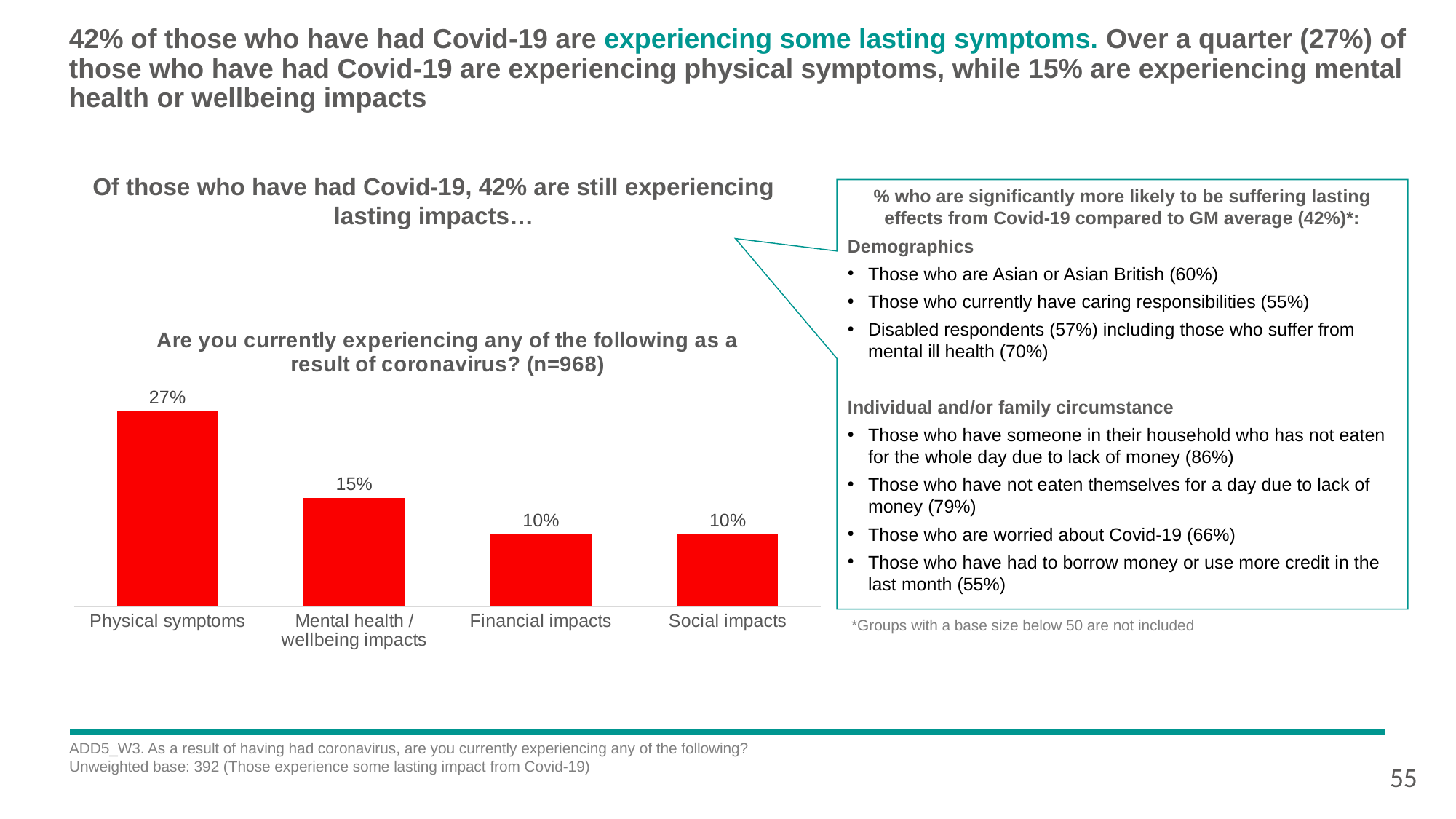
What is the value shown for mental health / wellbeing impacts? 15% Which category has the highest value in the chart? Physical symptoms How many categories are shown in the bar chart? 4 What type of chart is used to show the lasting impacts of coronavirus? Bar chart What is the difference between the values for mental health / wellbeing impacts and financial impacts? 5 percentage points Which is larger, the value for physical symptoms or the value for social impacts? Physical symptoms What percentage are experiencing financial impacts? 10% What percentage of respondents are experiencing physical symptoms as a result of coronavirus? 27% What is the difference between the values for physical symptoms and mental health / wellbeing impacts? 12 percentage points Do the values rise or fall moving from left to right across the categories? Fall What sample size (n) is stated in the chart title? n=968 What is the value for social impacts? 10%